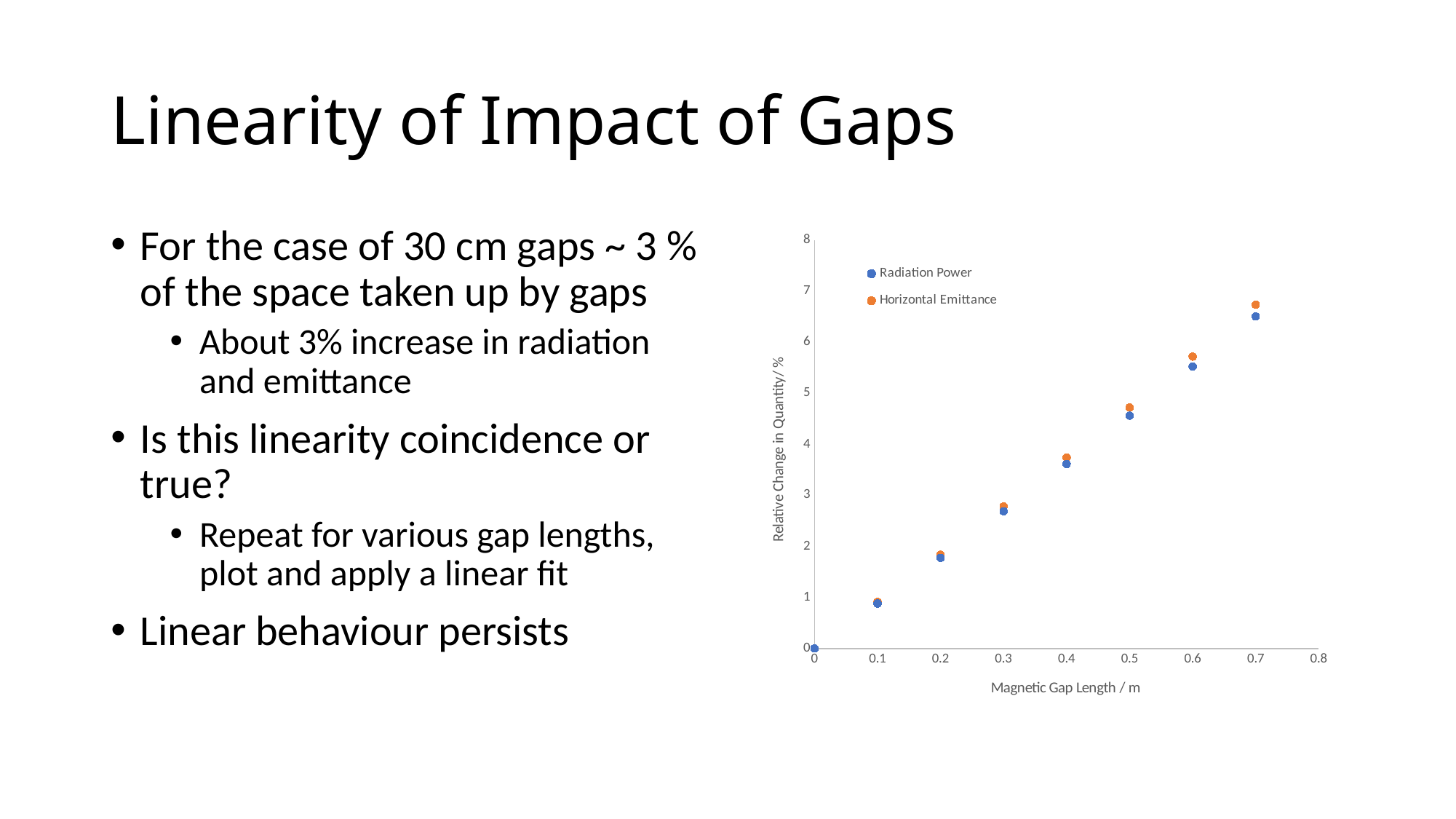
Do the Radiation Power values rise or fall as Magnetic Gap Length increases? rise Which two series are listed in the chart legend? Radiation Power and Horizontal Emittance Is the Radiation Power value at a Magnetic Gap Length of 0.7 greater or less than 6? greater Is the Horizontal Emittance value at a Magnetic Gap Length of 0.3 greater or less than 3? less What is the title of the x axis of the chart? Magnetic Gap Length / m At which Magnetic Gap Length is the Horizontal Emittance value highest? 0.7 What is the Relative Change in Quantity for Radiation Power at a Magnetic Gap Length of 0? 0 At a Magnetic Gap Length of 0.7, which series has the larger value, Radiation Power or Horizontal Emittance? Horizontal Emittance At which Magnetic Gap Length is the Radiation Power value lowest? 0 How many series does the chart legend list? 2 What kind of chart is shown on the slide? scatter chart How many data points are plotted for the Radiation Power series? 8